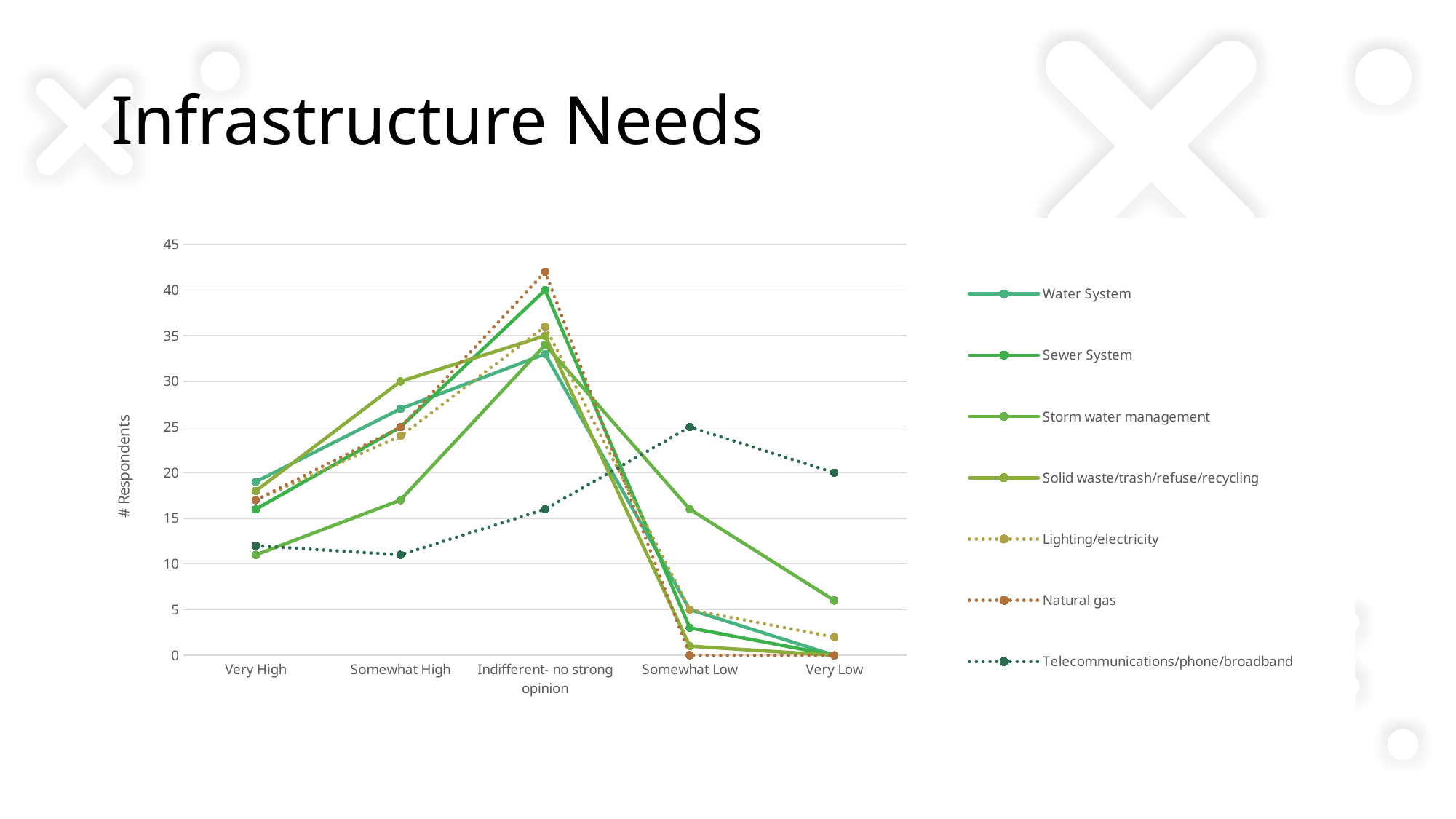
What is the label on the y axis? # Respondents What is the value for Solid waste/trash/refuse/recycling at Somewhat High? 30 What kind of chart is shown on the slide? line chart What is the value for Telecommunications/phone/broadband at Somewhat Low? 25 Is the value for Natural gas at Indifferent- no strong opinion greater or less than 40? greater Is the value for Storm water management at Very High greater or less than 15? less Does the Storm water management line rise or fall from Indifferent- no strong opinion to Very Low? fall Which series has the highest value at Somewhat Low? Telecommunications/phone/broadband How many categories are shown on the x axis? 5 What is the value for Telecommunications/phone/broadband at Very Low? 20 What is the value for Sewer System at Indifferent- no strong opinion? 40 How many series does the legend list? 7